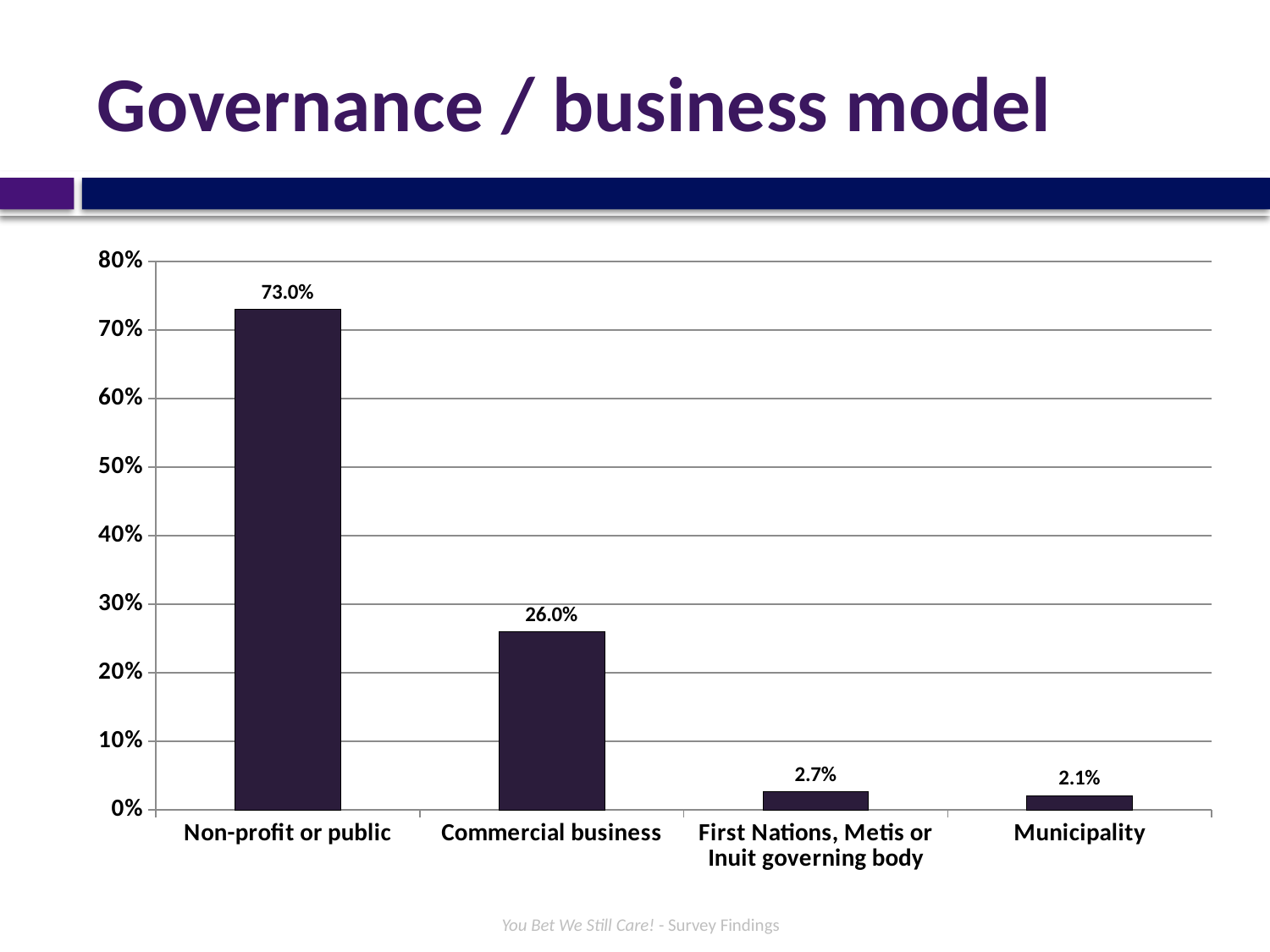
What is the title of the slide? Governance / business model What is the value for First Nations, Metis or Inuit governing body? 2.7% What is the value for Non-profit or public? 73.0% Which category has the lowest value? Municipality What is the value for Municipality? 2.1% Which category has the highest value? Non-profit or public How many categories are shown on the x axis? 4 Which is larger, the value for Commercial business or the value for Municipality? Commercial business What is the difference between the values for Non-profit or public and Commercial business? 47.0% What is the value for Commercial business? 26.0% Is the value for Commercial business greater or less than 30%? less What kind of chart is shown on the slide? bar chart